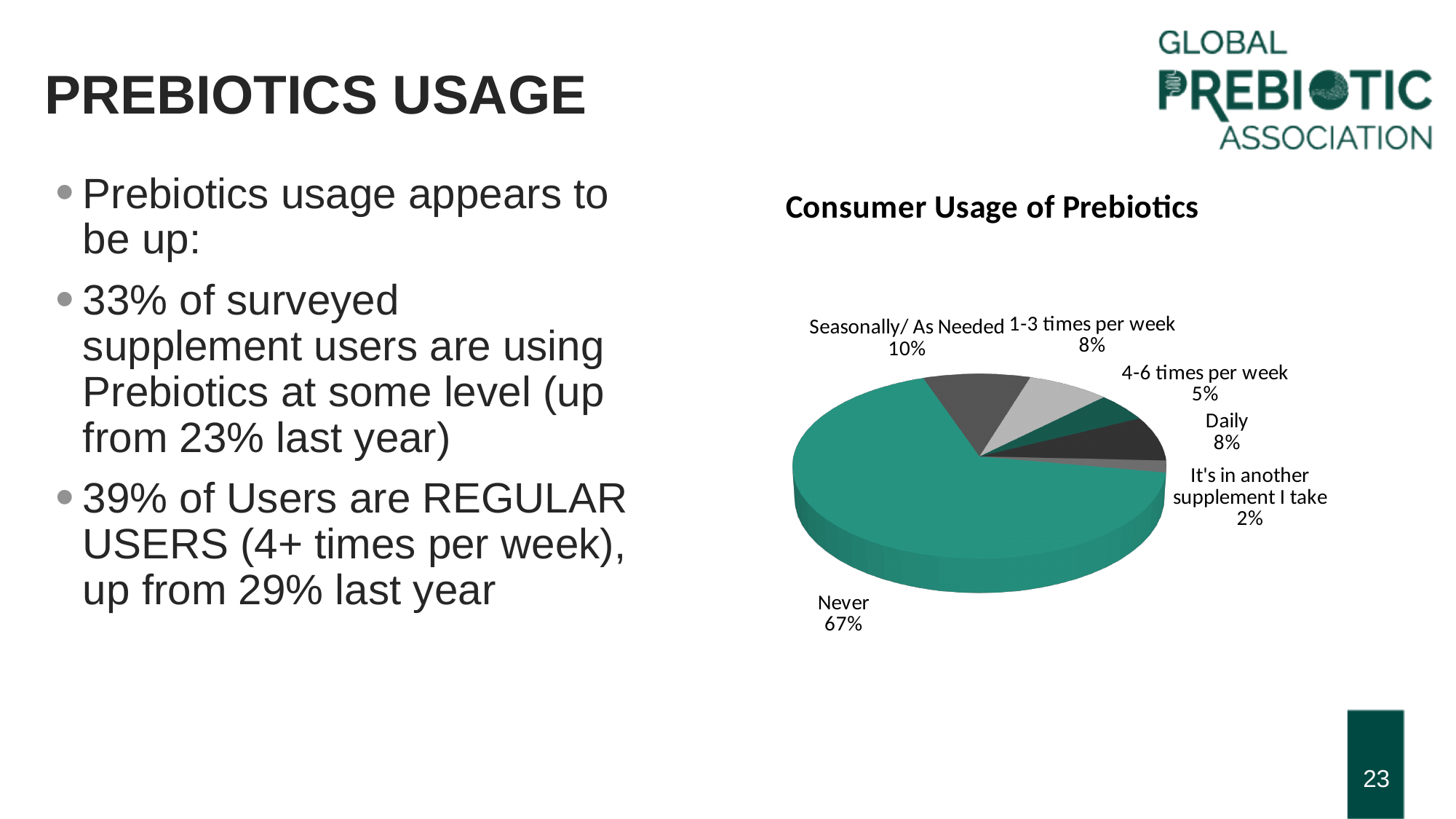
What percentage is shown for It's in another supplement I take? 2% What percentage is shown for 4-6 times per week? 5% What is the title of the chart? Consumer Usage of Prebiotics What percentage is shown for Seasonally/ As Needed? 10% What kind of chart is shown on the slide? Pie chart How many categories are shown in the pie chart? 6 What share of the pie is labelled Never? 67% Which category has the largest slice of the pie? Never What is the combined share of Daily and 1-3 times per week? 16% Which is larger, the share for Daily or the share for 4-6 times per week? Daily Which category has the smallest slice of the pie? It's in another supplement I take What is the difference between the Never share and the Seasonally/ As Needed share? 57%